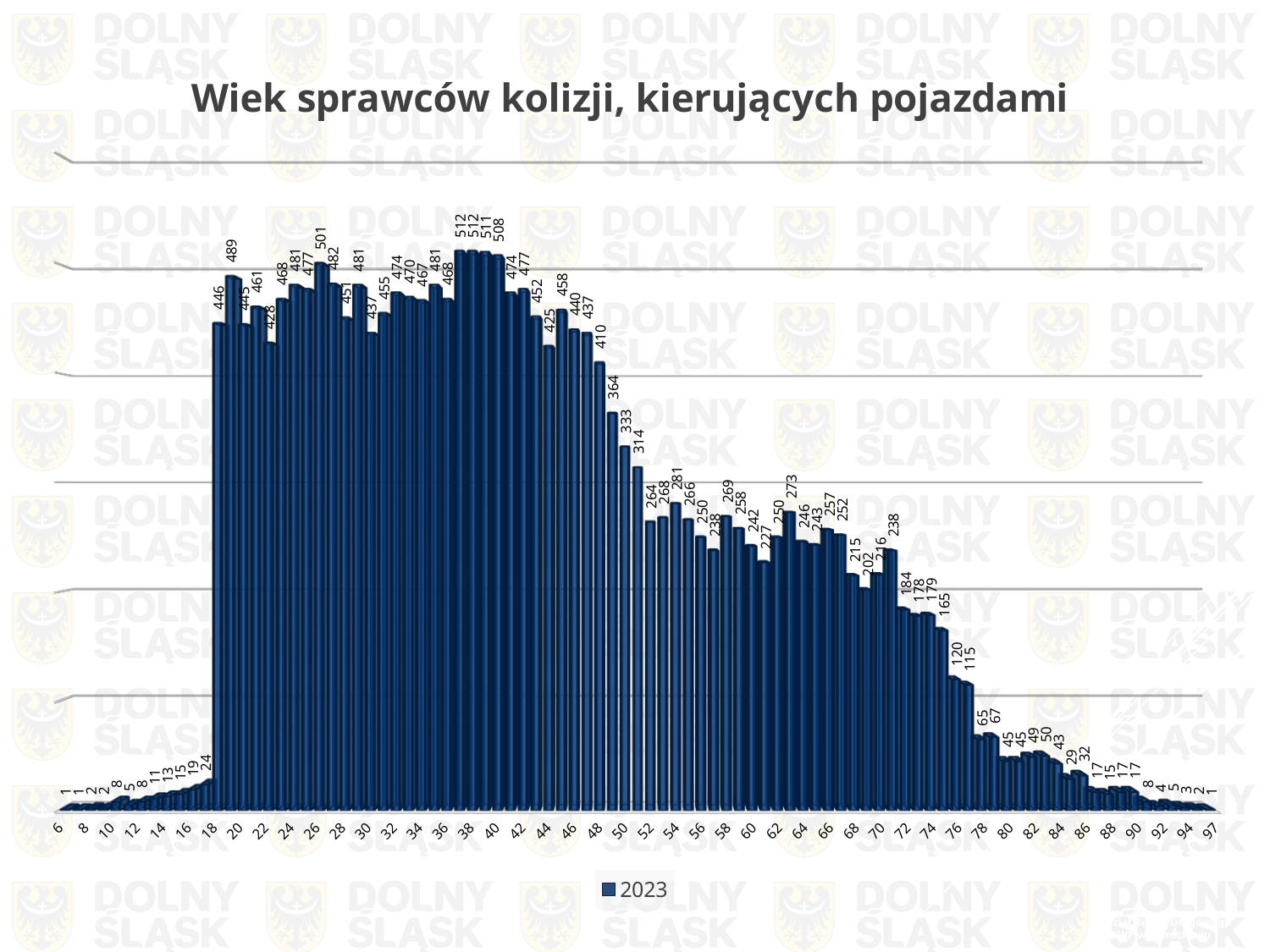
What series name is shown in the legend? 2023 Which has a larger value, age 18 or age 19? age 19 What is the value for age 76? 120 Do the values generally rise or fall along the x axis from age 50 to age 97? fall How many series does the legend list? 1 What is the highest value shown on the chart? 512 What is the value for age 26? 501 What is the difference between the highest value on the chart and the value for age 18? 66 What is the title of the chart? Wiek sprawców kolizji, kierujących pojazdami What is the value for age 97? 1 What type of chart is shown on the slide? bar chart What is the value for age 18? 446